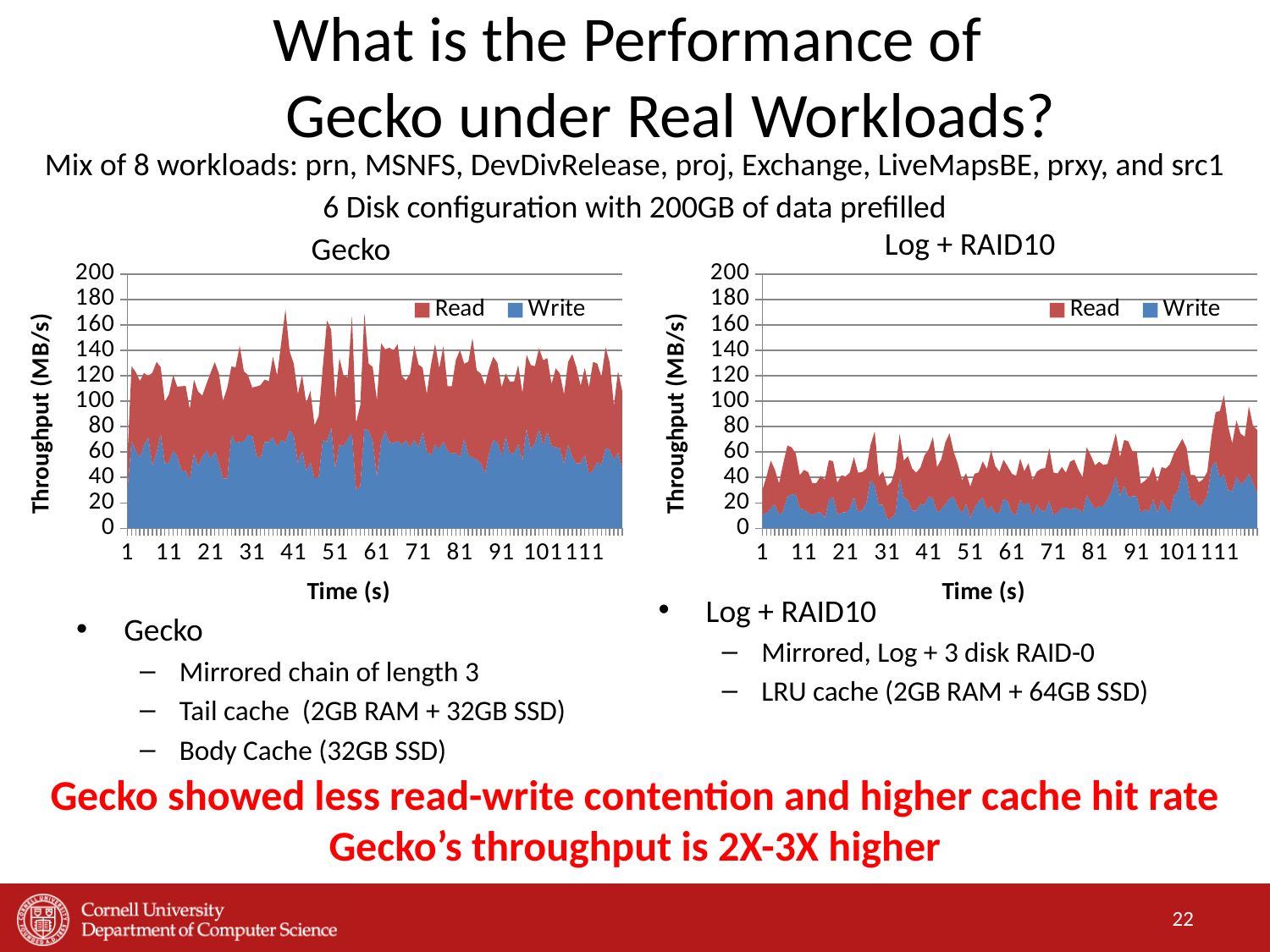
In the Log + RAID10 chart, which series contributes more throughput, Read or Write? Read In the Gecko chart, is the peak total throughput around time 41 greater or less than 140? greater How many series does the legend of the Log + RAID10 chart list? 2 In the Gecko chart, is the Write throughput at time 1 greater or less than 100? less In the Log + RAID10 chart, is the total throughput at time 1 greater or less than 100? less What is the maximum value shown on the y axis of the Gecko chart? 200 What kind of chart is the Gecko chart? Stacked area chart What is the y-axis title of the Log + RAID10 chart? Throughput (MB/s) Which chart shows higher overall total throughput, Gecko or Log + RAID10? Gecko What are the two series named in the legend of the Gecko chart? Read and Write